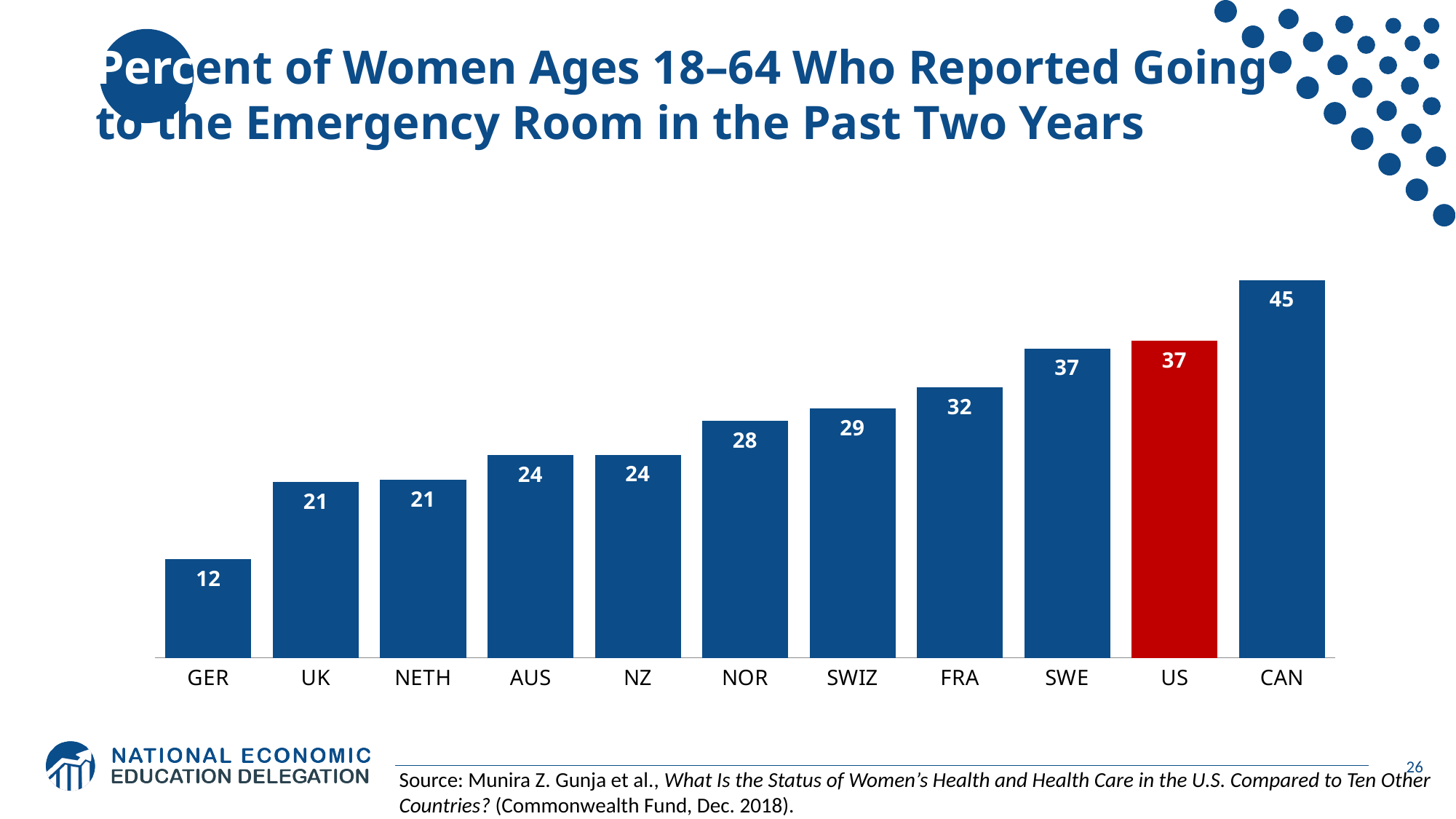
Which country has the highest value? CAN Which bar is coloured red instead of blue? US What is the value for NOR? 28 What kind of chart is shown on the slide? bar chart How many countries are shown on the chart? 11 What is the value for GER? 12 What is the difference between the values for CAN and the US? 8 What is the difference between the values for FRA and GER? 20 Which is larger, the value for SWIZ or the value for AUS? SWIZ What is the value for the US? 37 Do the values rise or fall from left to right across the chart? rise Which country has the lowest value? GER